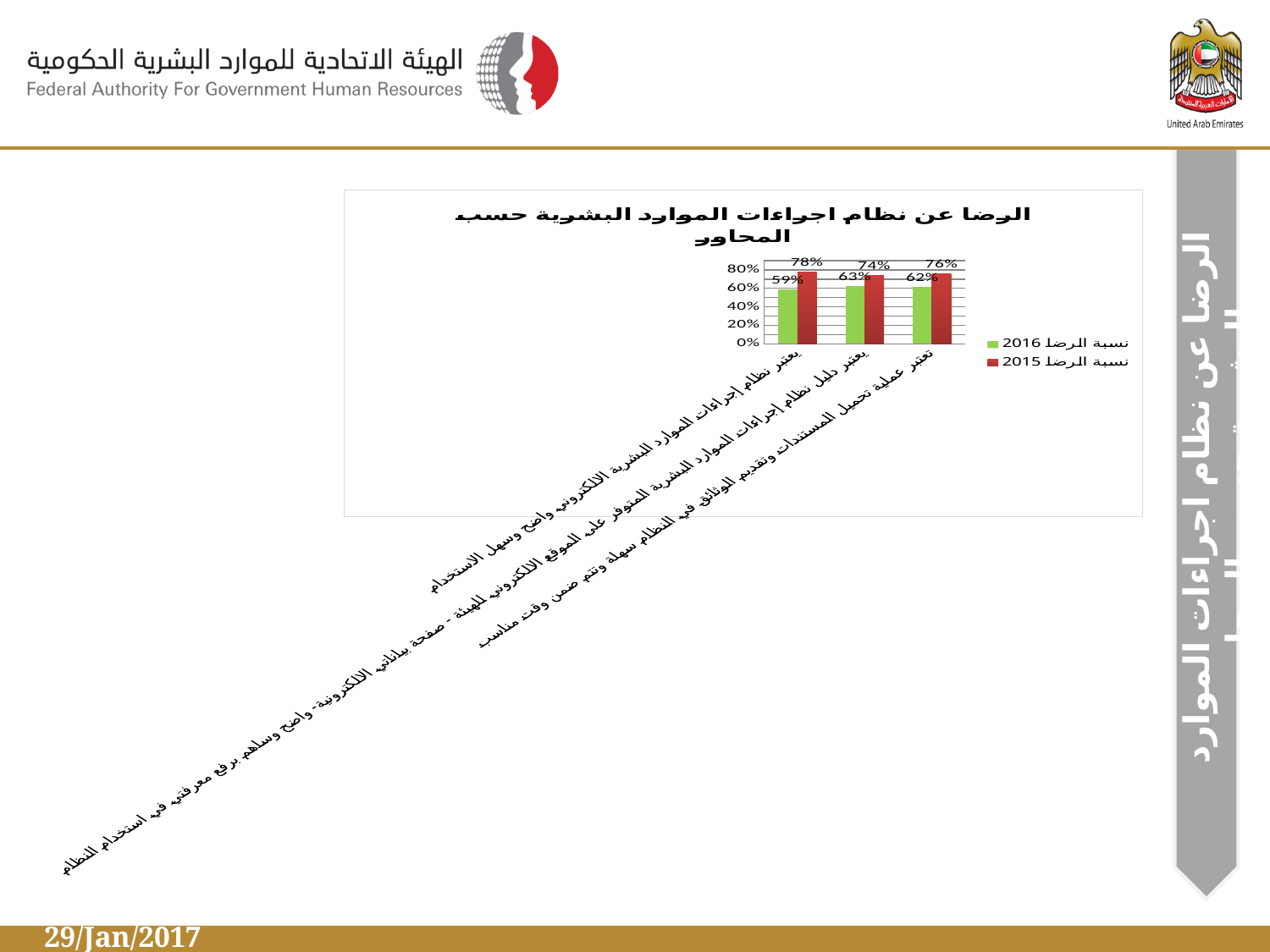
What type of chart is shown on the slide? bar chart What is the value of نسبة الرضا 2015 for the third (rightmost) category, 'تعتبر عملية تحميل المستندات وتقديم الوثائق في النظام سهلة وتتم ضمن وقت مناسب'? 76% What is the value of نسبة الرضا 2016 for the first (leftmost) category, 'يعتبر نظام إجراءات الموارد البشرية الالكتروني واضح وسهل الاستخدام'? 59% What is the difference between نسبة الرضا 2015 and نسبة الرضا 2016 for the first (leftmost) category? 19% What is the value of نسبة الرضا 2015 for the first (leftmost) category, 'يعتبر نظام إجراءات الموارد البشرية الالكتروني واضح وسهل الاستخدام'? 78% Which category has the lowest value for نسبة الرضا 2015? the middle category (يعتبر دليل نظام إجراءات الموارد البشرية ...) Which category has the highest value for نسبة الرضا 2016? the middle category (يعتبر دليل نظام إجراءات الموارد البشرية ...) What is the value of نسبة الرضا 2016 for the middle category (the one about دليل نظام إجراءات الموارد البشرية)? 63% For the third (rightmost) category, which is larger: نسبة الرضا 2016 or نسبة الرضا 2015? نسبة الرضا 2015 How many series does the chart legend list? 2 How many categories are plotted on the x axis of the chart? 3 What colour represents نسبة الرضا 2016 in the chart? green